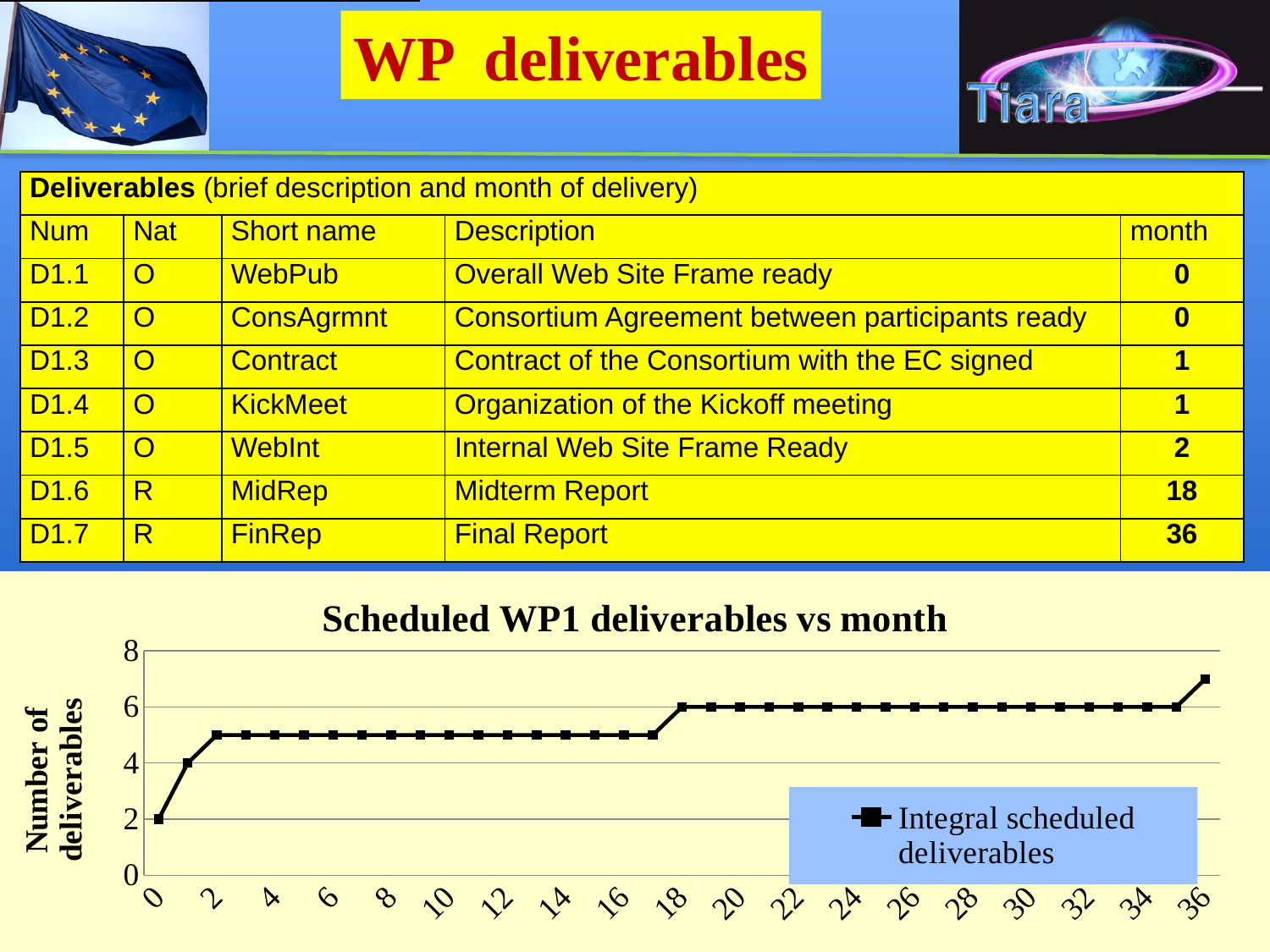
Which is larger, the value at month 36 or the value at month 0? month 36 Is the value at month 36 greater or less than 6? greater Do the values rise or fall as the month increases along the x axis? rise What is the name of the series shown in the chart legend? Integral scheduled deliverables What is the number of deliverables at month 0? 2 How many series does the chart legend list? 1 What type of chart is shown on the slide? line chart Is the value at month 10 greater or less than 6? less What is the title of the chart? Scheduled WP1 deliverables vs month What is the number of deliverables at month 18? 6 At which month is the number of deliverables lowest? 0 At which month is the number of deliverables highest? 36